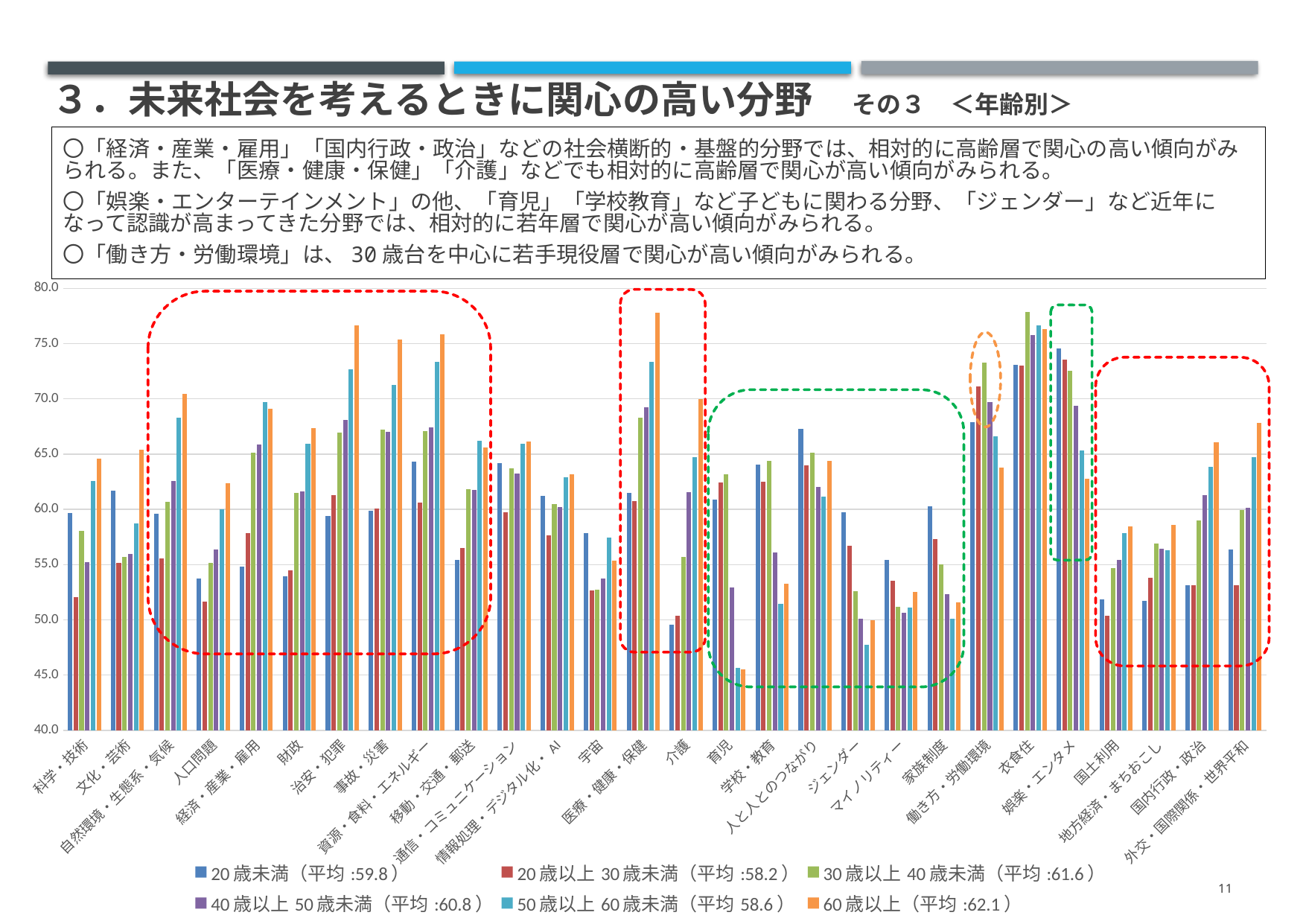
How many categories are shown along the x axis? 28 Is the value for 50歳以上60歳未満 in 人口問題 greater or less than 65? less For the 60歳以上 series, which is larger: 衣食住 or 育児? 衣食住 For the 60歳以上 series, which category has the lowest value? 育児 What kind of chart is shown on the slide? bar chart How many series does the legend list? 6 Is the value for 20歳以上30歳未満 in 科学・技術 greater or less than 55? less Is the value for 20歳未満 in 娯楽・エンタメ greater or less than 70? greater According to the legend, what is the average (平均) for the 60歳以上 series? 62.1